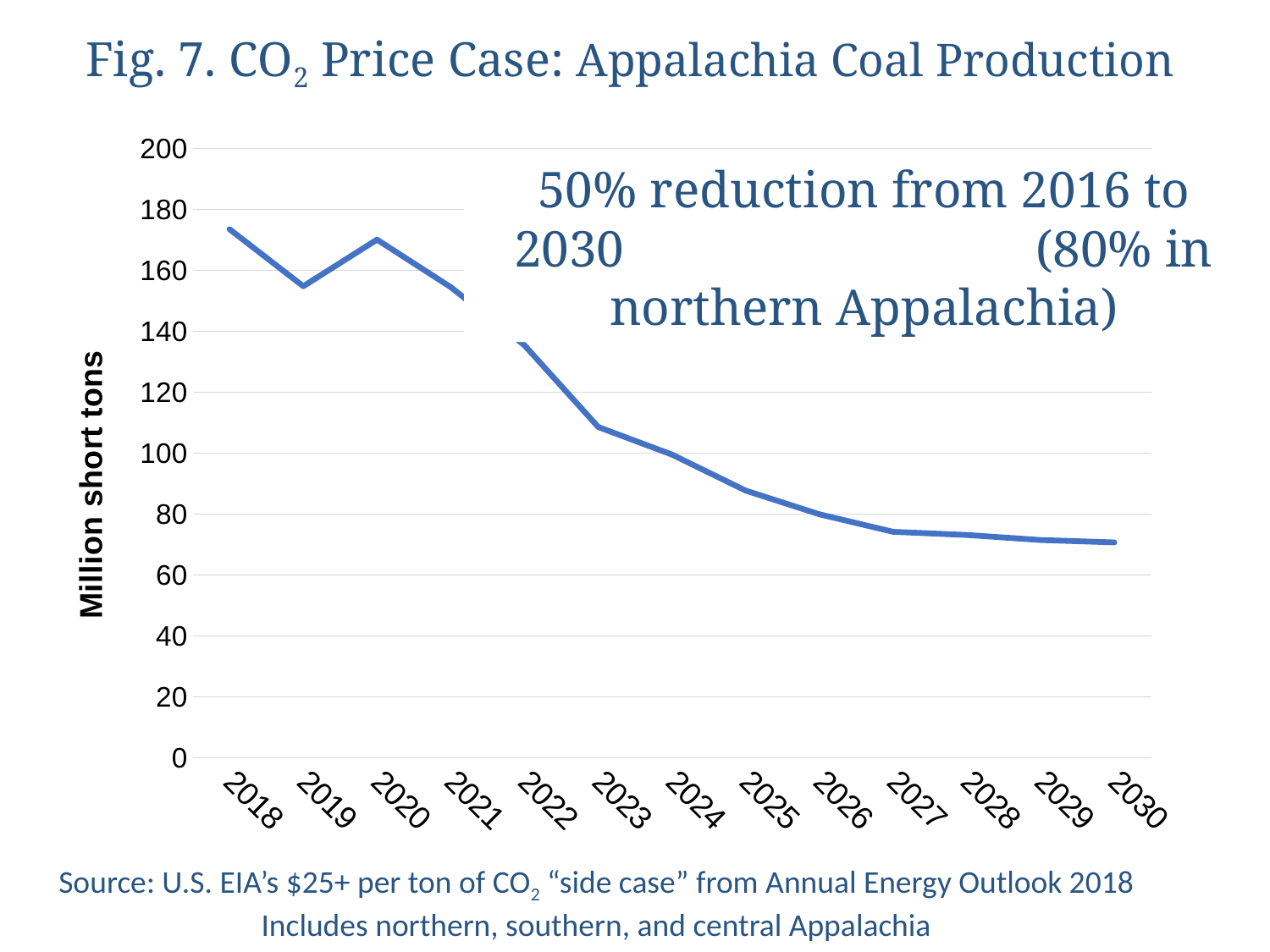
Is the value for 2018 greater or less than 160? greater Is the value for 2030 greater or less than 80? less Is the value for 2023 greater or less than 100? greater What is the label on the y axis? Million short tons What is the title of the chart? Fig. 7. CO2 Price Case: Appalachia Coal Production Do the values generally rise or fall from 2018 to 2030? fall Which year has the larger value, 2018 or 2023? 2018 Which year has the larger value, 2019 or 2020? 2020 How many years are plotted along the x axis? 13 What kind of chart is shown on the slide? line chart